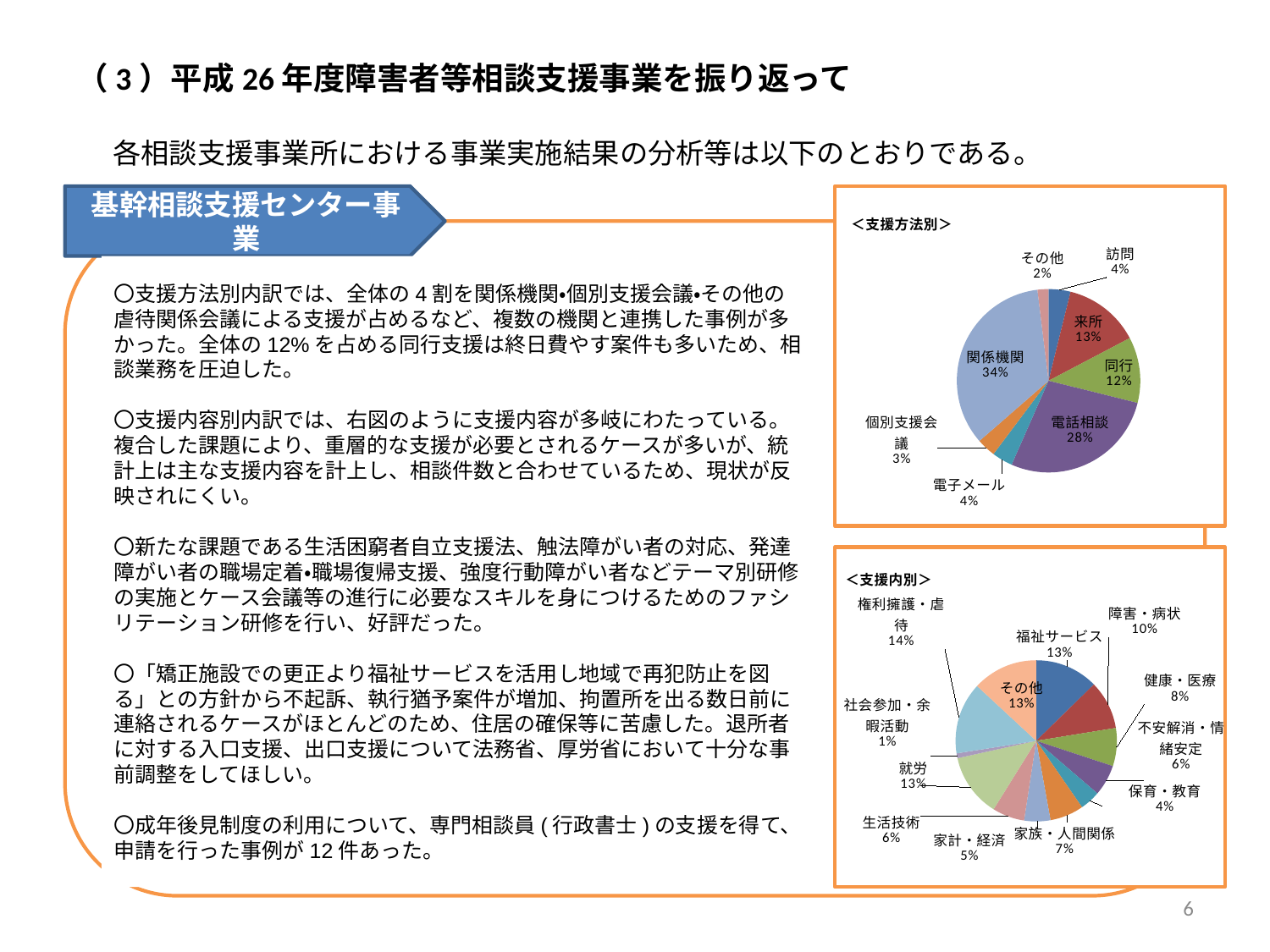
In the <支援方法別> pie chart, which category has the smallest share? その他 How many categories does the <支援内容別> pie chart show? 12 In the <支援内容別> pie chart, what percentage is shown for 権利擁護・虐待? 14% How many categories does the <支援方法別> pie chart show? 8 In the <支援方法別> pie chart, what percentage is shown for 関係機関? 34% In the <支援方法別> pie chart, which category has the largest share? 関係機関 What type of chart is the <支援内容別> chart? Pie chart In the <支援内容別> pie chart, what is the difference in percentage points between 就労 and 家計・経済? 8 In the <支援内容別> pie chart, which category has the smallest share? 社会参加・余暇活動 In the <支援方法別> pie chart, what is the difference in percentage points between 関係機関 and 電話相談? 6 In the <支援方法別> pie chart, which is larger, 来所 or 同行? 来所 In the <支援方法別> pie chart, what percentage is shown for 電話相談? 28%